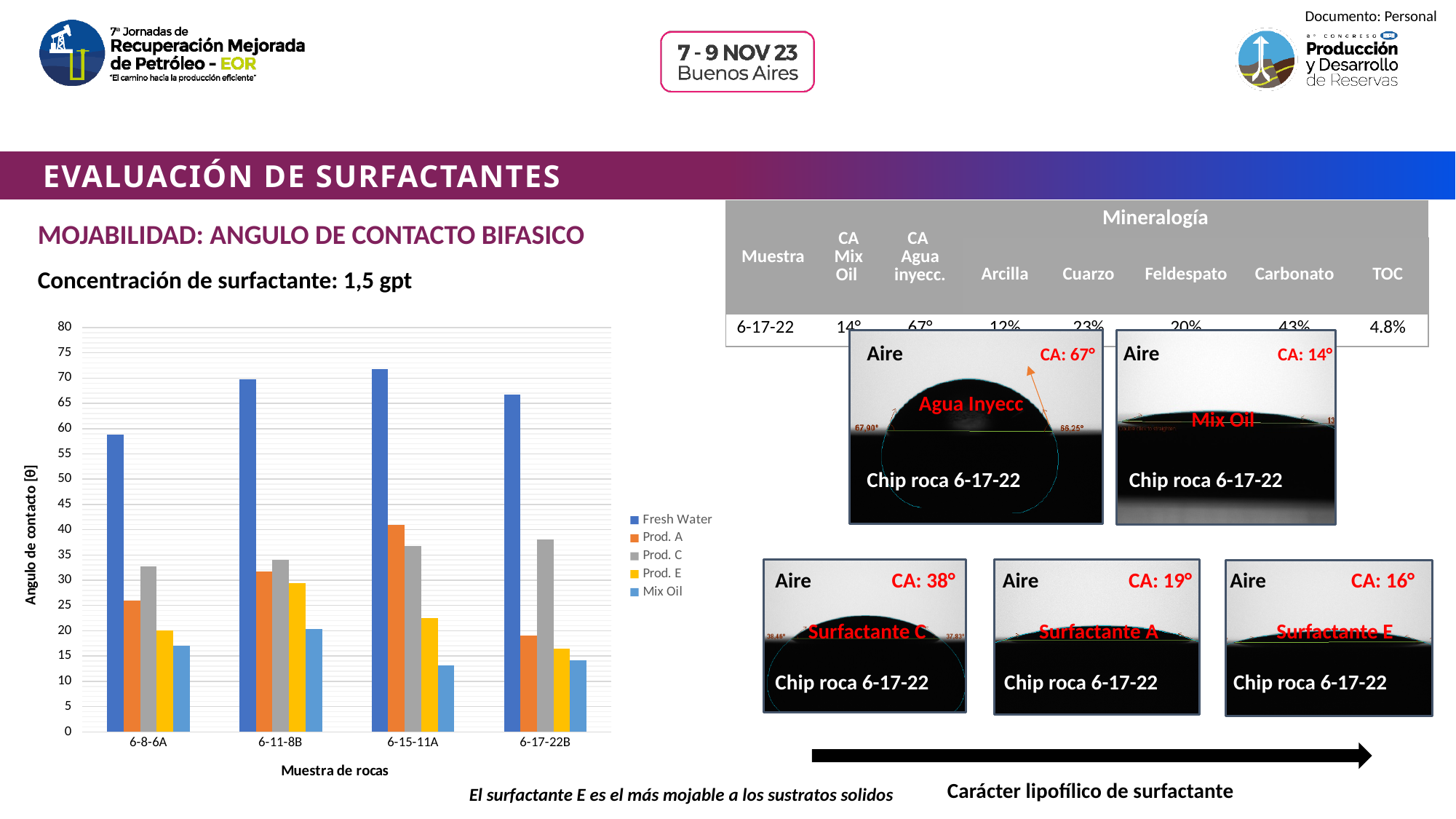
What kind of chart is shown on the left of the slide? bar chart Which series has the highest contact angle for every rock sample in the bar chart? Fresh Water For sample 6-15-11A, which is larger: Prod. E or Mix Oil? Prod. E For which rock sample is the Fresh Water contact angle the lowest? 6-8-6A How many series does the legend of the bar chart list? 5 How many rock samples (categories) are shown on the x axis of the bar chart? 4 What is the title of the y axis of the bar chart? Angulo de contacto [θ] Is the Fresh Water value for 6-11-8B greater or less than 65? greater Is the Mix Oil value for 6-15-11A greater or less than 15? less For sample 6-17-22B, which is larger: Prod. A or Prod. C? Prod. C Is the Prod. A value for 6-15-11A greater or less than 35? greater For which rock sample is the Fresh Water contact angle the highest? 6-15-11A